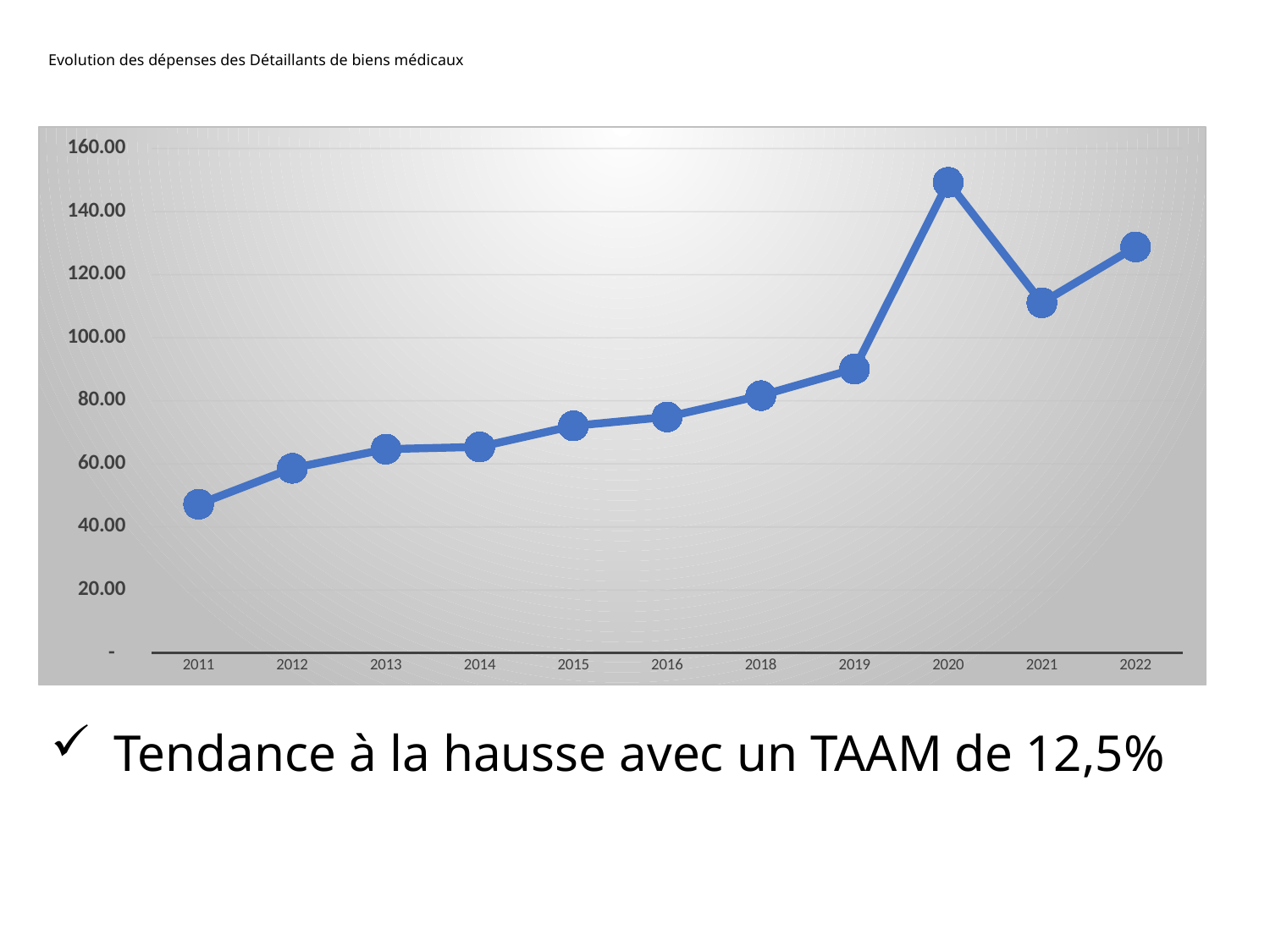
Is the value for 2022 greater or less than 140? less Do the values generally rise or fall from 2011 to 2019? rise Which year has the lowest value in the chart? 2011 How many years are plotted on the x axis of the chart? 11 What kind of chart is shown on the slide? Line chart Which year has the larger value, 2020 or 2022? 2020 Is the value for 2020 greater or less than 140? greater Is the value for 2011 greater or less than 60? less Which year has the highest value in the chart? 2020 Which year has the larger value, 2019 or 2021? 2021